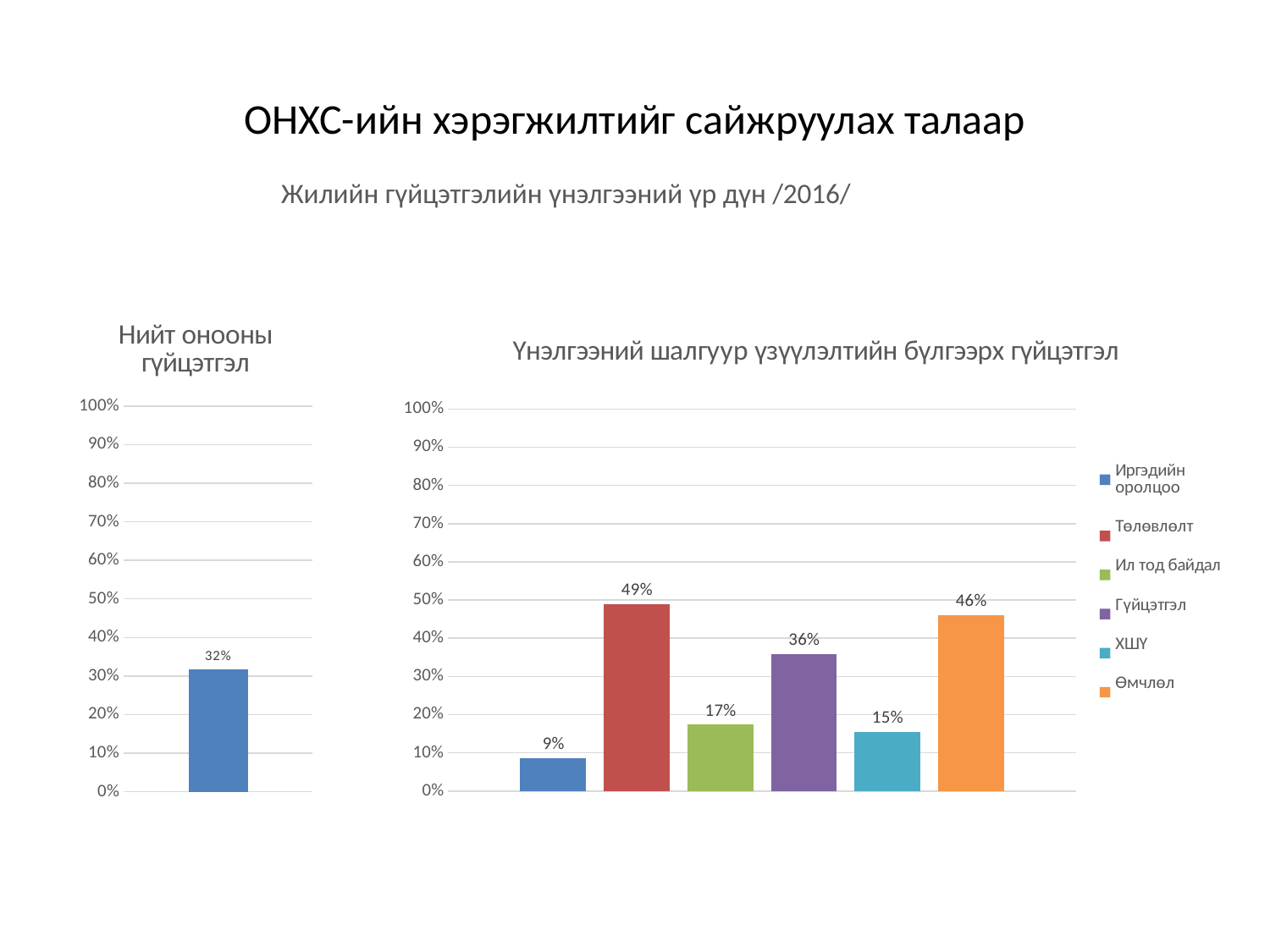
In the right-hand chart, what colour is the bar for Өмчлөл? Orange In the chart titled "Нийт онооны гүйцэтгэл" on the left, what value is shown for the single bar? 32% What kind of chart is the right-hand chart titled "Үнэлгээний шалгуур үзүүлэлтийн бүлгээрх гүйцэтгэл"? Bar chart In the right-hand chart, which series has the lowest value? Иргэдийн оролцоо In the right-hand chart, what is the value for Өмчлөл? 46% In the right-hand chart, what is the value for Иргэдийн оролцоо? 9% In the chart titled "Үнэлгээний шалгуур үзүүлэлтийн бүлгээрх гүйцэтгэл" on the right, what is the value for Төлөвлөлт? 49% In the right-hand chart, which is larger: the value for Ил тод байдал or the value for ХШҮ? Ил тод байдал In the right-hand chart, what is the difference between the values for Төлөвлөлт and Гүйцэтгэл? 13% How many series does the legend of the right-hand chart list? 6 In the right-hand chart, which series has the highest value? Төлөвлөлт In the right-hand chart, is the value for Гүйцэтгэл greater or less than 30%? greater